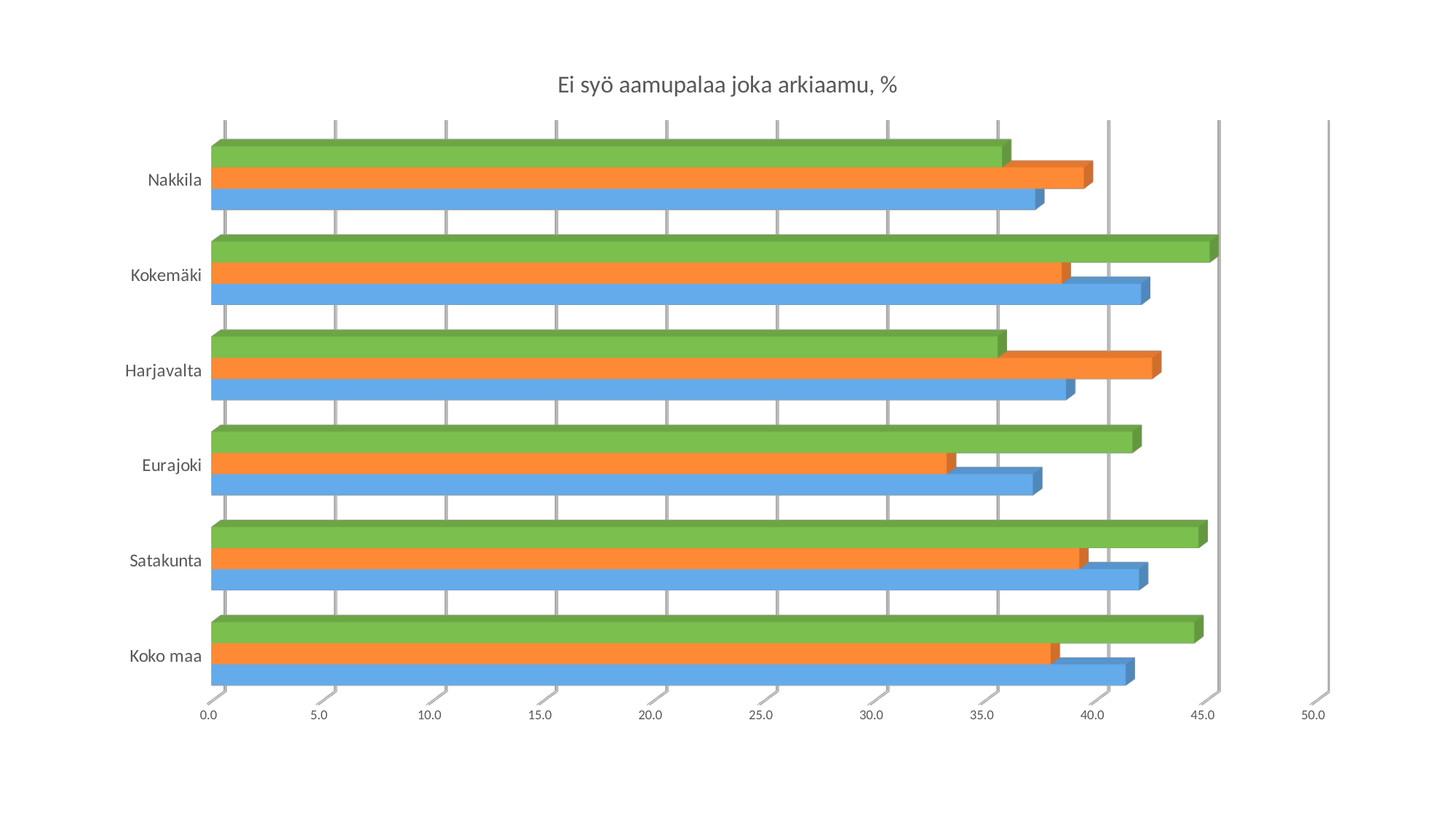
Is the value of the green bar for Satakunta greater or less than 40.0? greater What kind of chart is shown on the slide? bar chart Is the value of the orange bar for Eurajoki greater or less than 35.0? less How many bars are plotted for each category in the chart? 3 Is the value of the blue bar for Eurajoki greater or less than 40.0? less For Harjavalta, which bar is longer, the orange bar or the green bar? orange What is the title of the chart? Ei syö aamupalaa joka arkiaamu, % For Kokemäki, which bar is longer, the green bar or the orange bar? green Which category has the shortest orange bar? Eurajoki How many categories are shown on the vertical axis of the chart? 6